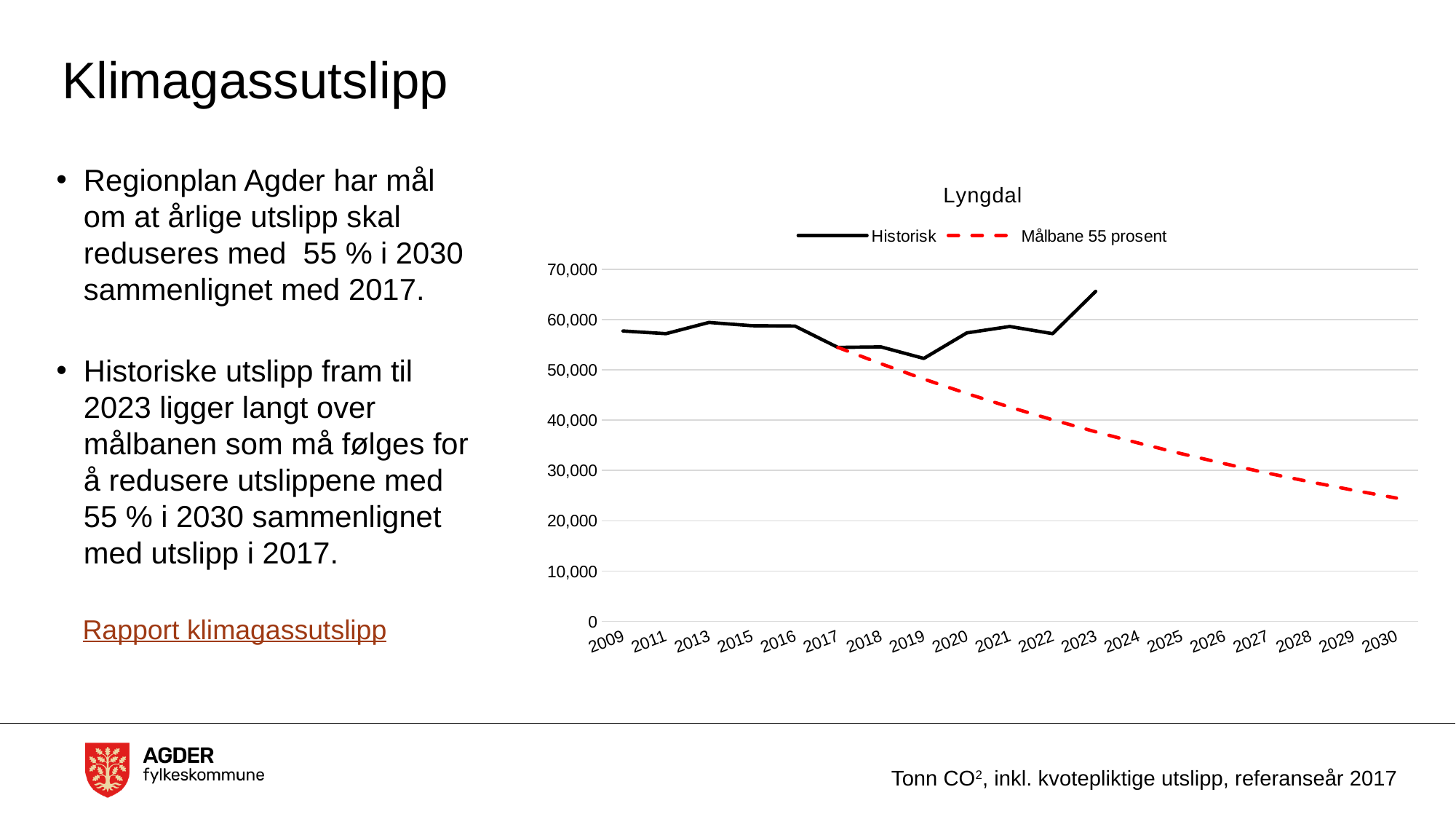
What are the two series named in the chart legend? Historisk and Målbane 55 prosent In 2023, which series has the larger value, Historisk or Målbane 55 prosent? Historisk Is the Målbane 55 prosent value for 2030 greater or less than 30,000? less Is the Historisk value for 2023 greater or less than 60,000? greater How many series does the chart legend list? 2 In which year does the Historisk series reach its highest value? 2023 In which year does the Historisk series reach its lowest value? 2019 How many year labels are shown on the x axis of the chart? 19 What is the title of the chart? Lyngdal What kind of chart is shown on the slide? Line chart Does the Målbane 55 prosent series rise or fall from 2017 to 2030? Fall Is the Historisk value for 2009 greater or less than 60,000? less